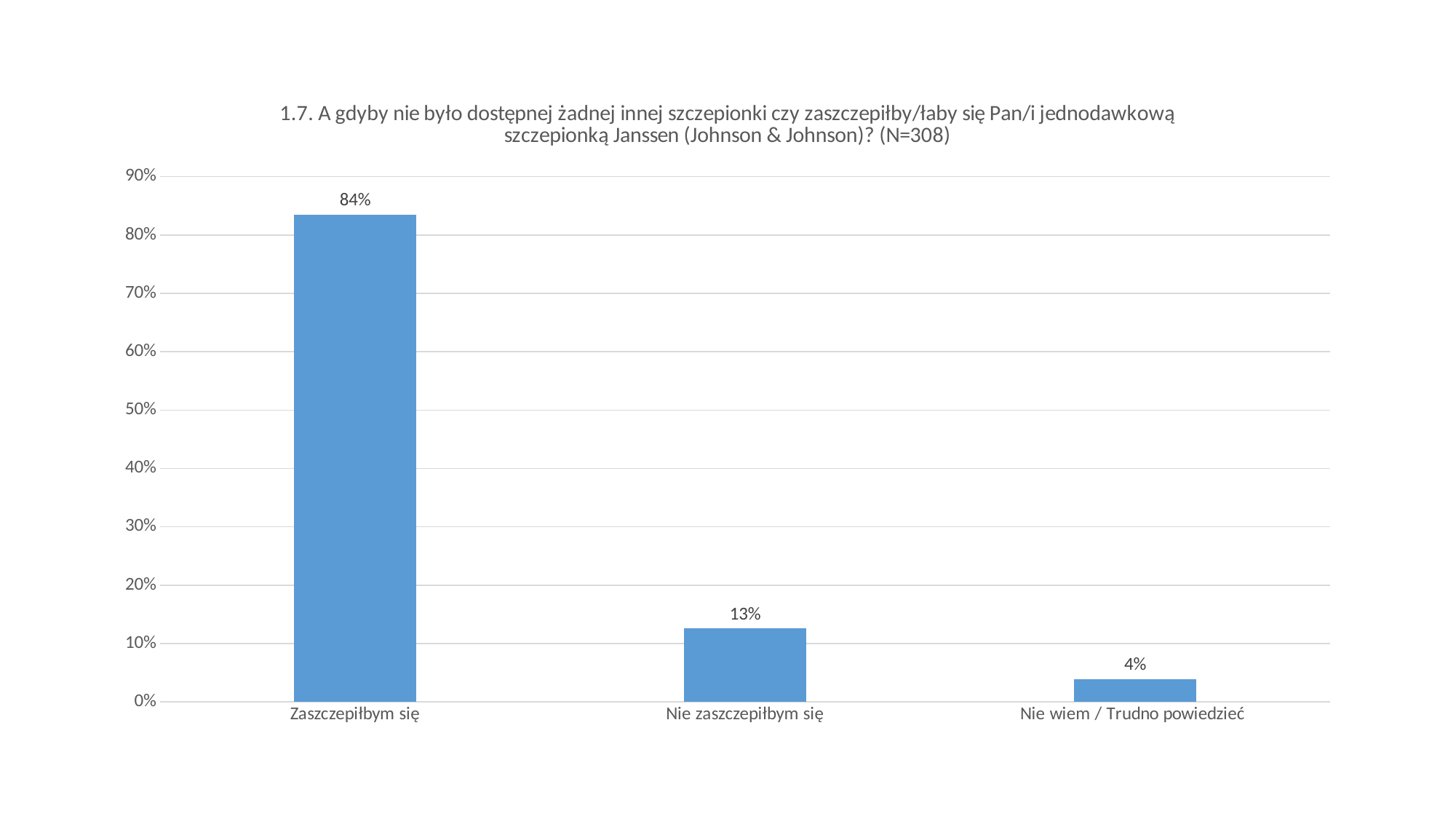
What is the difference between the values for "Zaszczepiłbym się" and "Nie zaszczepiłbym się"? 71% What is the difference between the values for "Nie zaszczepiłbym się" and "Nie wiem / Trudno powiedzieć"? 9% Which is larger, the value for "Nie zaszczepiłbym się" or the value for "Nie wiem / Trudno powiedzieć"? Nie zaszczepiłbym się How many categories are shown on the x axis? 3 Is the value for "Zaszczepiłbym się" greater or less than 80%? greater What is the sample size (N) stated in the chart title? 308 What is the value for "Zaszczepiłbym się"? 84% What is the value for "Nie zaszczepiłbym się"? 13% Which category has the lowest value? Nie wiem / Trudno powiedzieć Which category has the highest value? Zaszczepiłbym się What kind of chart is shown on the slide? bar chart What is the value for "Nie wiem / Trudno powiedzieć"? 4%